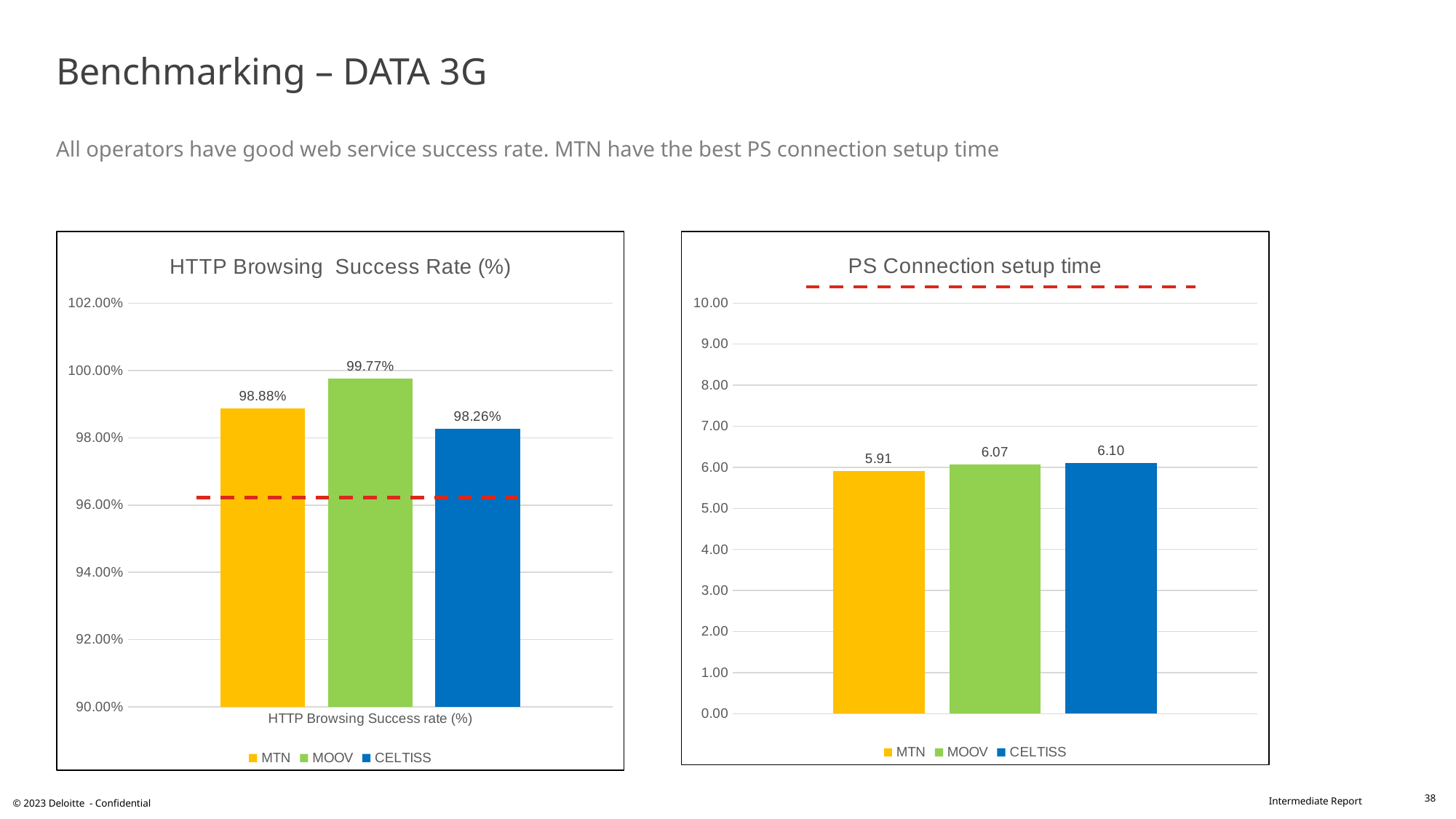
In the PS Connection setup time chart, what is the value for CELTISS? 6.10 In the HTTP Browsing Success Rate (%) chart, what is the value for CELTISS? 98.26% What kind of chart is the PS Connection setup time chart? bar chart In the HTTP Browsing Success Rate (%) chart, what is the difference between MOOV and MTN? 0.89% In the PS Connection setup time chart, is the value for MOOV greater or less than 7.00? less In the HTTP Browsing Success Rate (%) chart, which operator has the lowest success rate? CELTISS In the PS Connection setup time chart, which operator has the lowest setup time? MTN In the HTTP Browsing Success Rate (%) chart, what is the value for MOOV? 99.77% In the HTTP Browsing Success Rate (%) chart, which operator has the highest success rate? MOOV In the PS Connection setup time chart, what is the value for MTN? 5.91 In the HTTP Browsing Success Rate (%) chart, how many series does the legend list? 3 In the PS Connection setup time chart, what is the difference between CELTISS and MTN? 0.19